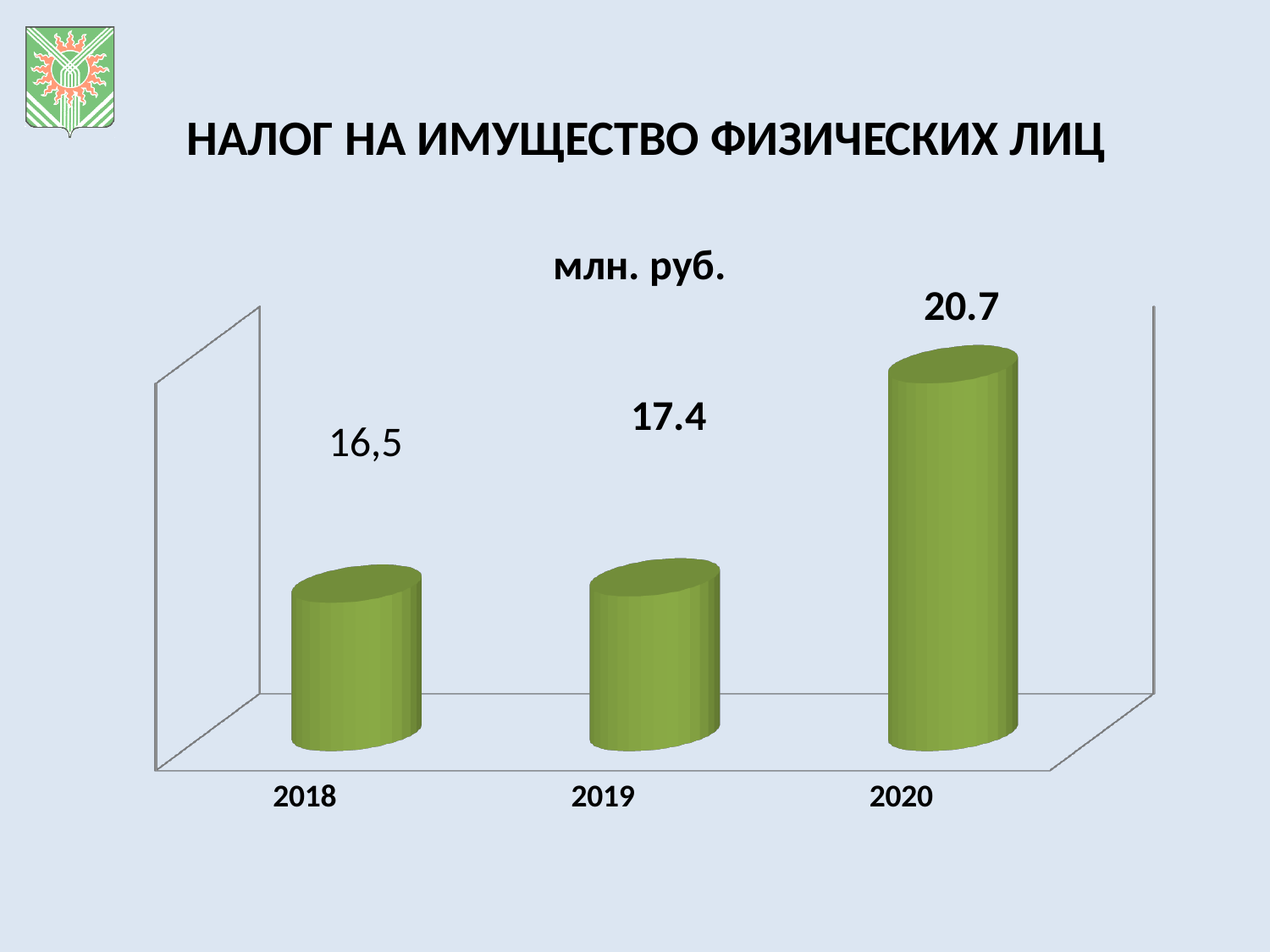
What is the value for 2018? 16,5 Which year has the lowest value? 2018 What is the difference between the values for 2020 and 2019? 3.3 Do the values rise or fall from 2018 to 2020? rise What kind of chart is shown on the slide? bar chart Which is larger, the value for 2019 or the value for 2020? 2020 Which year has the highest value? 2020 What is the difference between the values for 2020 and 2018? 4.2 How many years are shown on the chart? 3 What is the value for 2020? 20.7 What is the value for 2019? 17.4 What is the difference between the values for 2019 and 2018? 0.9